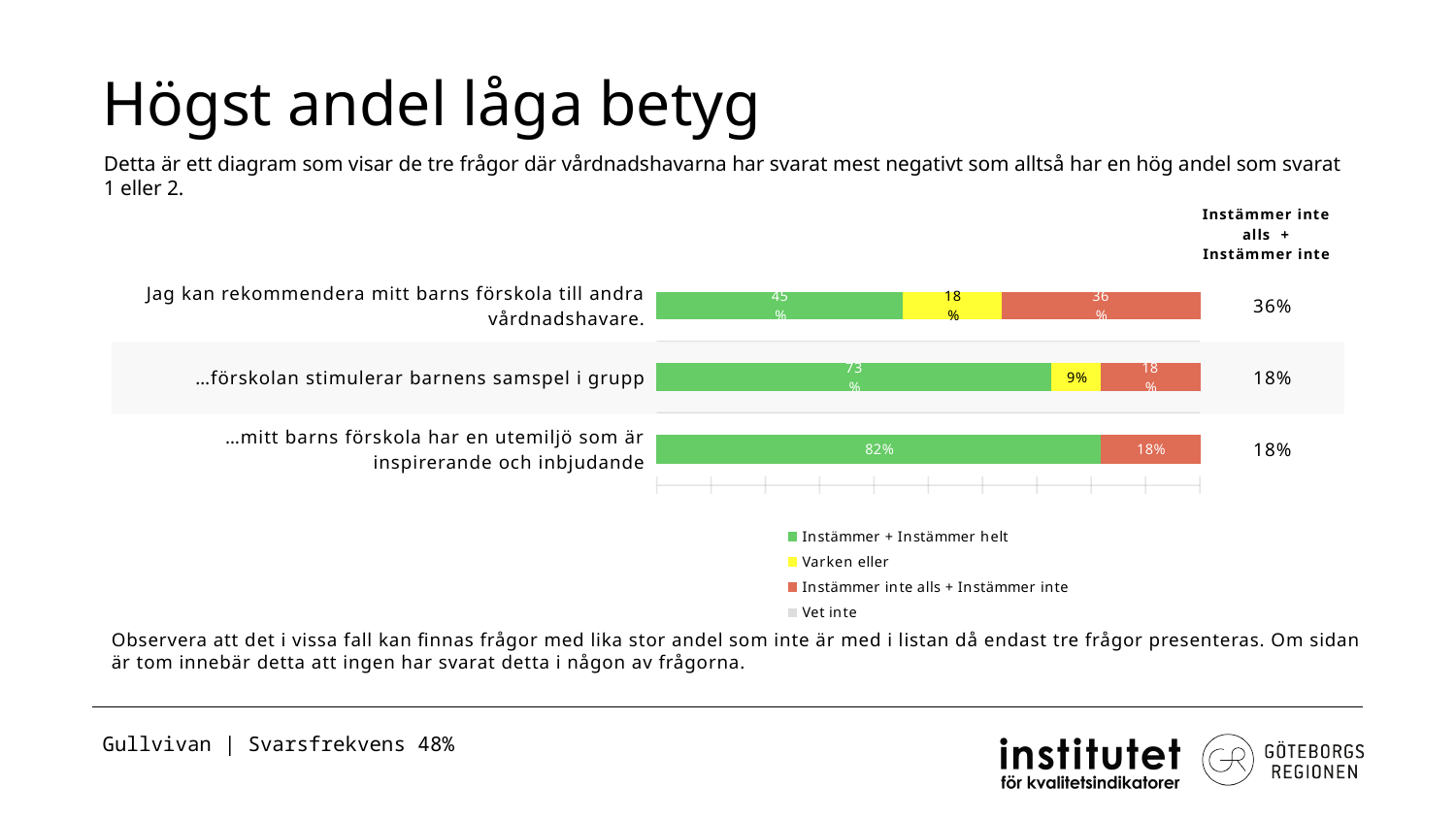
Which question has the lowest 'Instämmer + Instämmer helt' share? Jag kan rekommendera mitt barns förskola till andra vårdnadshavare. What colour represents 'Instämmer inte alls + Instämmer inte' in the chart? red What is the difference between the 'Instämmer + Instämmer helt' values for '…mitt barns förskola har en utemiljö som är inspirerande och inbjudande' and 'Jag kan rekommendera mitt barns förskola till andra vårdnadshavare.'? 37% What kind of chart is shown on the slide? stacked bar chart Which is larger: the 'Varken eller' value for 'Jag kan rekommendera mitt barns förskola till andra vårdnadshavare.' or for '…förskolan stimulerar barnens samspel i grupp'? Jag kan rekommendera mitt barns förskola till andra vårdnadshavare. What is the 'Instämmer + Instämmer helt' value for 'Jag kan rekommendera mitt barns förskola till andra vårdnadshavare.'? 45% Which question has the highest 'Instämmer inte alls + Instämmer inte' share? Jag kan rekommendera mitt barns förskola till andra vårdnadshavare. How many series does the legend list? 4 How many questions (categories) are plotted in the chart? 3 What is the 'Instämmer + Instämmer helt' value for '…mitt barns förskola har en utemiljö som är inspirerande och inbjudande'? 82% What is the 'Instämmer inte alls + Instämmer inte' value for '…förskolan stimulerar barnens samspel i grupp'? 18% What is the 'Varken eller' value for '…förskolan stimulerar barnens samspel i grupp'? 9%